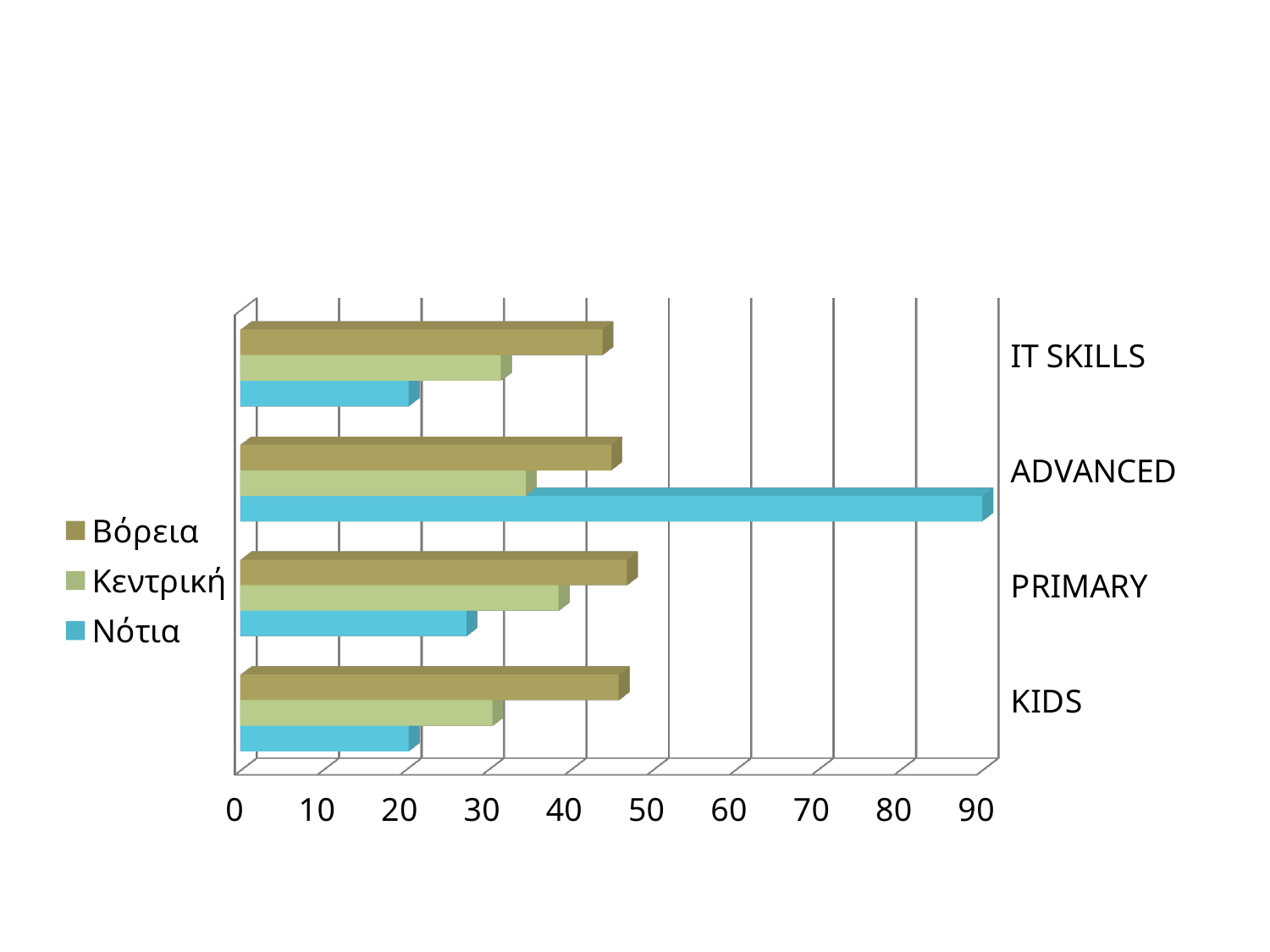
Is the Νότια value for IT SKILLS greater or less than 30? less How many categories are shown on the chart? 4 How many series does the legend list? 3 Is the Κεντρική value for KIDS greater or less than 40? less Which series is shown in blue in the legend? Νότια Is the Νότια value for ADVANCED greater or less than 80? greater What kind of chart is shown on the slide? bar chart Which category has the highest value for the Νότια series? ADVANCED Which is larger: the Νότια value for ADVANCED or the Νότια value for KIDS? ADVANCED Which series has the highest value for IT SKILLS? Βόρεια Which series has the lowest value for KIDS? Νότια